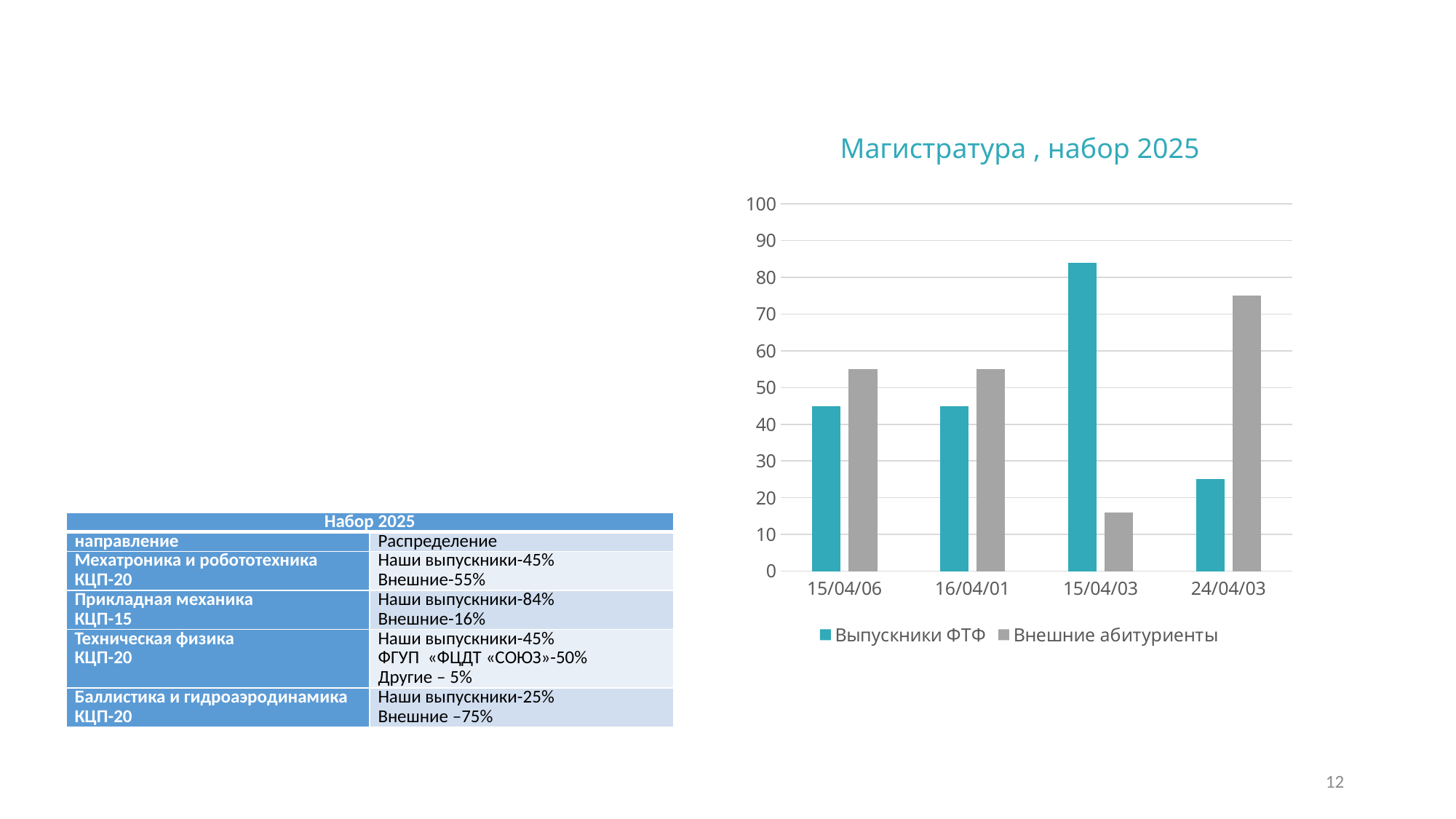
Which category has the lowest value for Выпускники ФТФ? 24/04/03 For 15/04/03, which series has the larger value: Выпускники ФТФ or Внешние абитуриенты? Выпускники ФТФ How many categories are shown on the x axis of the chart? 4 Which category has the lowest value for Внешние абитуриенты? 15/04/03 For 15/04/06, which series has the larger value: Выпускники ФТФ or Внешние абитуриенты? Внешние абитуриенты Which category has the highest value for Внешние абитуриенты? 24/04/03 What kind of chart is shown on the slide? bar chart Is the value for Внешние абитуриенты at 24/04/03 greater or less than 70? greater How many series does the chart legend list? 2 What is the title of the chart? Магистратура , набор 2025 Is the value for Выпускники ФТФ at 24/04/03 greater or less than 30? less Which category has the highest value for Выпускники ФТФ? 15/04/03